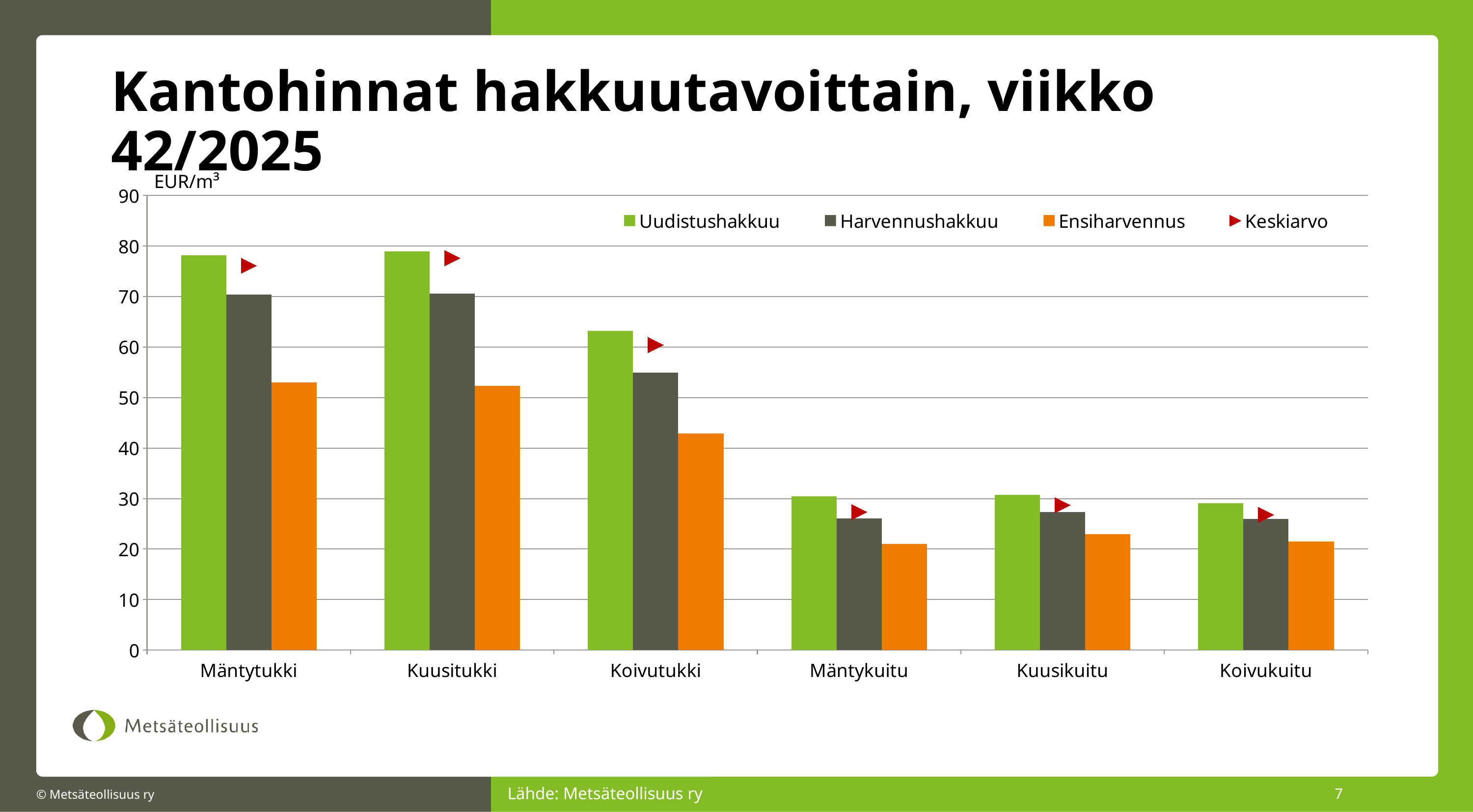
Which is larger, the Uudistushakkuu value for Koivutukki or the Uudistushakkuu value for Mäntykuitu? Koivutukki Is the Uudistushakkuu value for Mäntytukki greater or less than 70? greater What kind of chart is shown on the slide? bar chart Is the Harvennushakkuu value for Kuusitukki greater or less than 60? greater Is the Ensiharvennus value for Koivutukki greater or less than 50? less How many series does the legend list? 4 Which series is shown in orange? Ensiharvennus What unit is shown on the y axis? EUR/m³ How many categories are shown on the x axis? 6 For Mäntytukki, which series has the larger value, Uudistushakkuu or Ensiharvennus? Uudistushakkuu